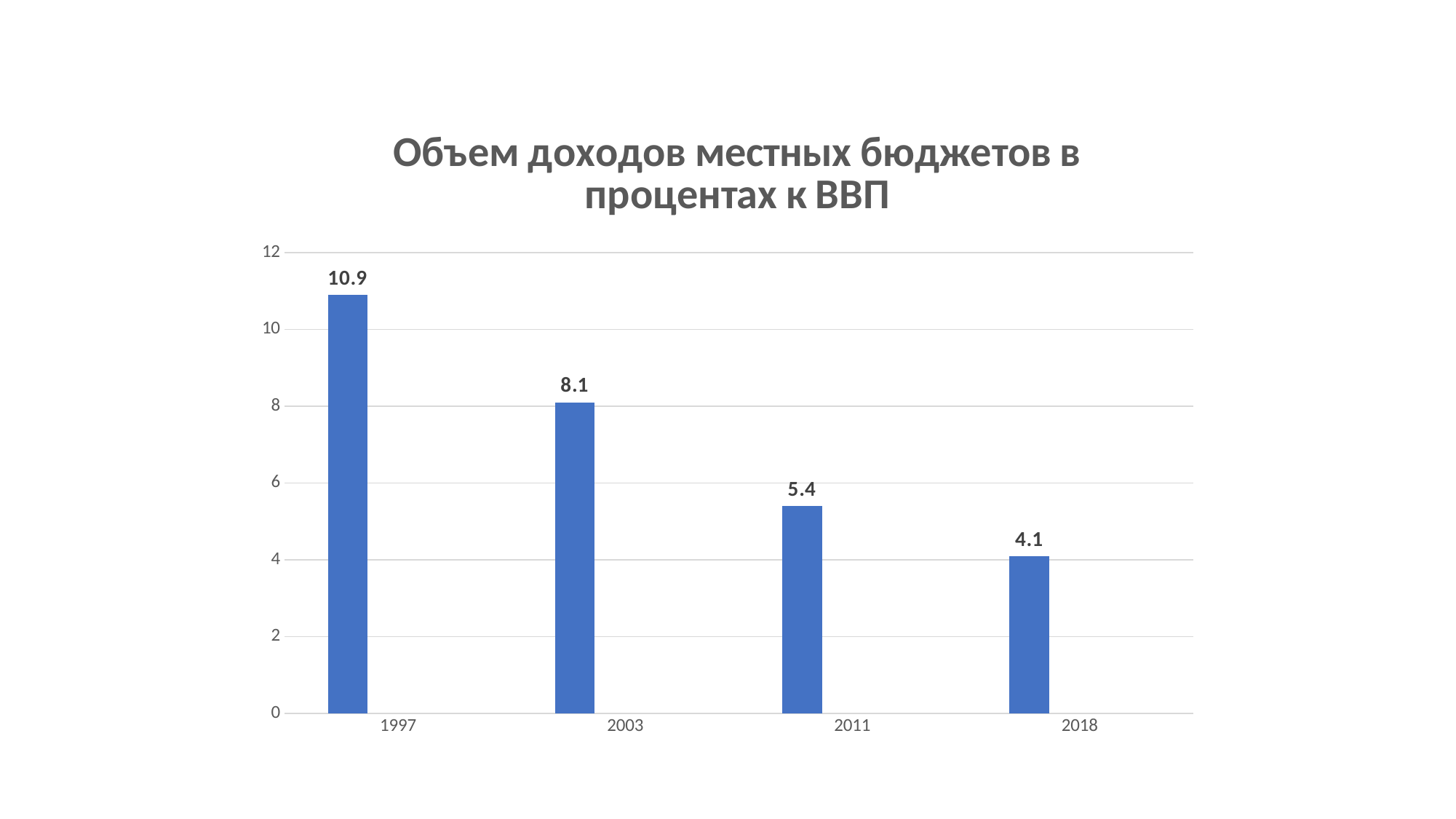
What is the value for 2018? 4.1 Which is larger, the value for 2003 or the value for 2011? 2003 What kind of chart is shown on the slide? bar chart What is the value for 1997? 10.9 What is the difference between the values for 1997 and 2018? 6.8 What is the value for 2011? 5.4 What is the value for 2003? 8.1 Do the values rise or fall from 1997 to 2018? fall Which year has the lowest value? 2018 How many years are shown on the chart? 4 What is the difference between the values for 2003 and 2011? 2.7 Which year has the highest value? 1997